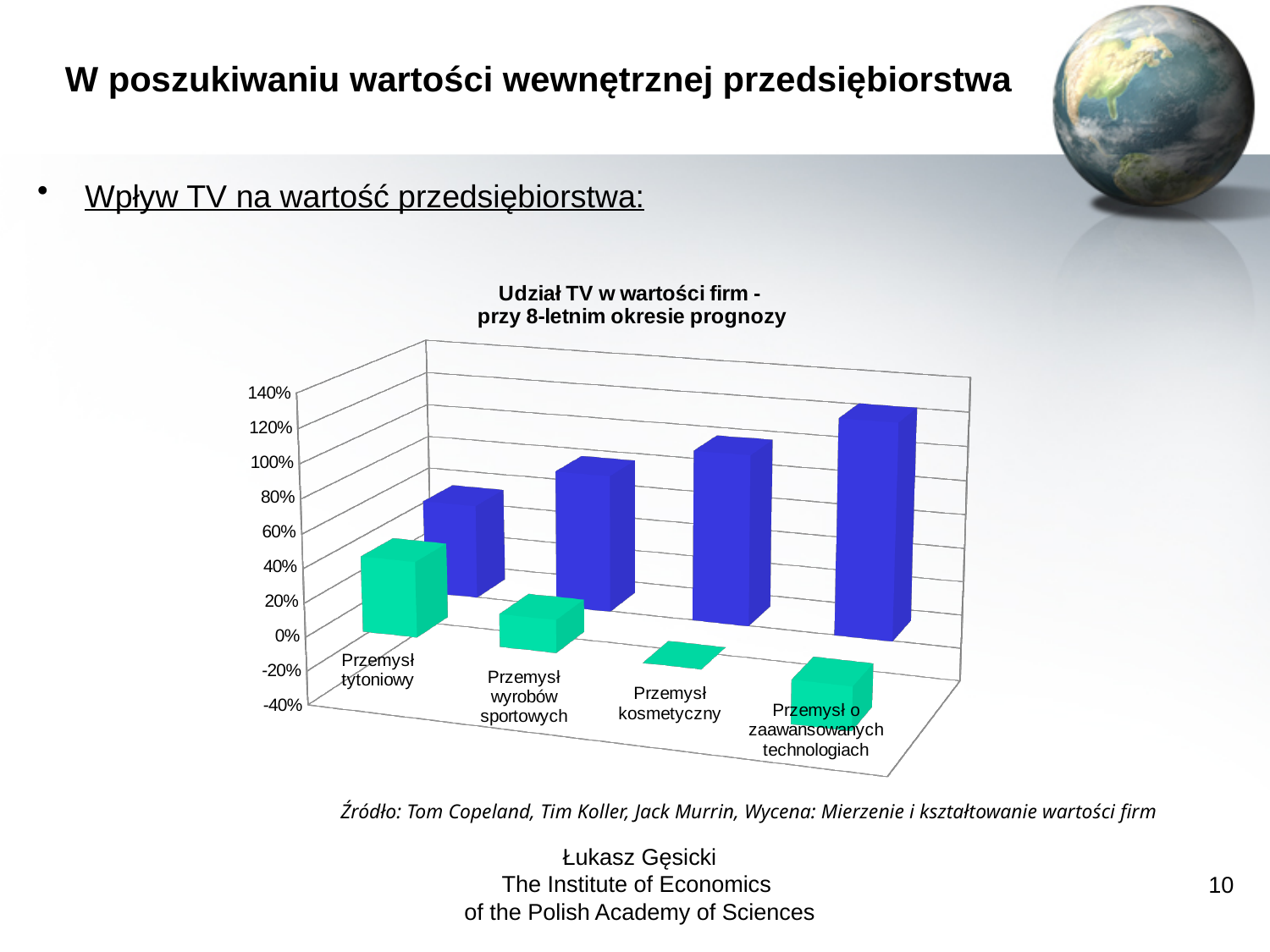
Is the blue bar for Przemysł tytoniowy greater or less than 100%? less Which is larger: the blue bar for Przemysł kosmetyczny or the blue bar for Przemysł tytoniowy? Przemysł kosmetyczny Is the green bar for Przemysł o zaawansowanych technologiach greater or less than 0%? less What is the title of the chart? Udział TV w wartości firm - przy 8-letnim okresie prognozy Which industry has the tallest blue bar? Przemysł o zaawansowanych technologiach Which industry has the lowest green bar? Przemysł o zaawansowanych technologiach Do the blue bars rise or fall from left to right across the industries? rise Do the green bars rise or fall from left to right across the industries? fall What kind of chart is shown on the slide? bar chart How many industry categories are shown on the x axis of the chart? 4 How many bars are plotted for each industry category? 2 Which industry has the tallest green bar? Przemysł tytoniowy